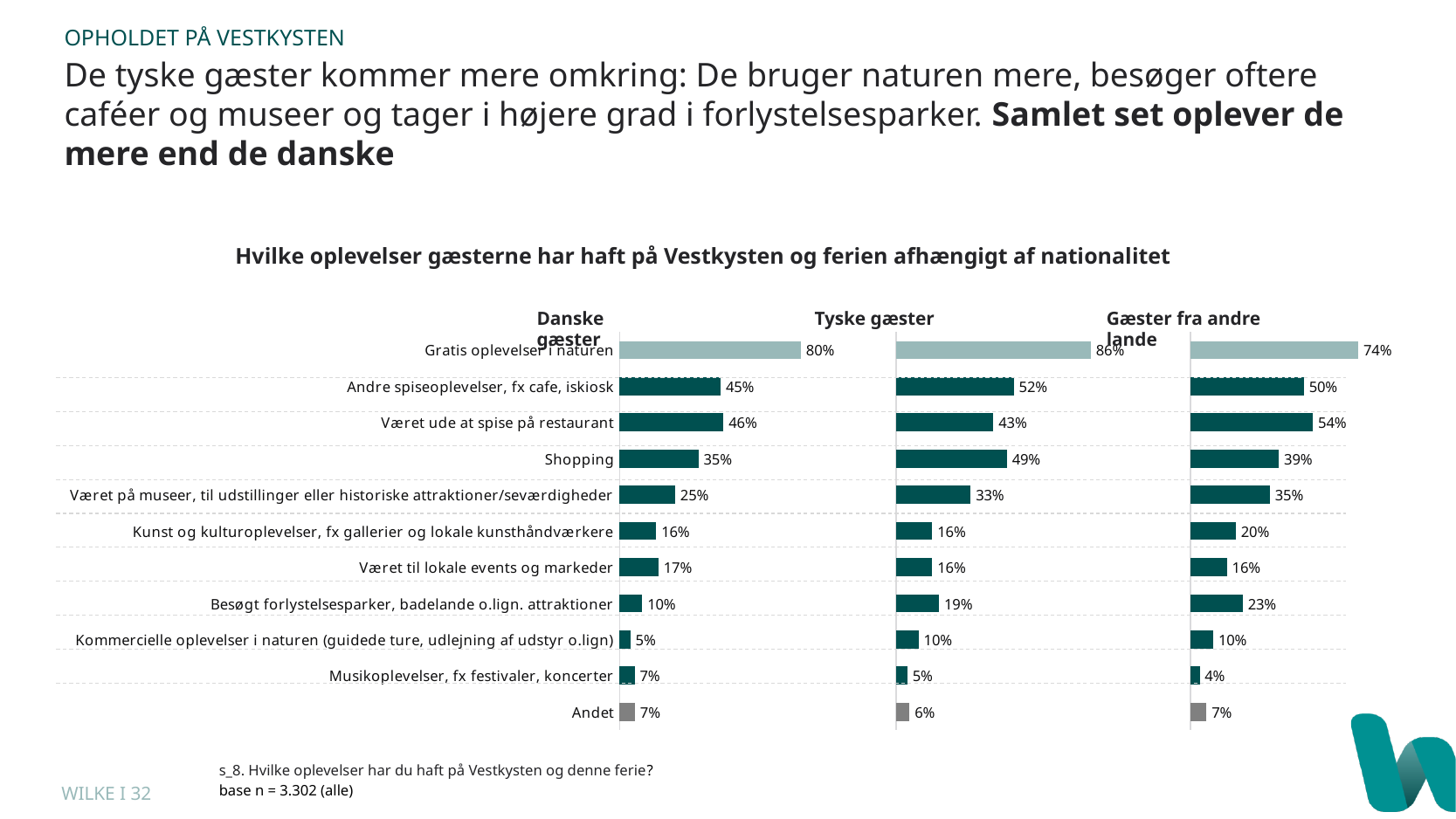
What is the difference between the Tyske gæster and Danske gæster values for Shopping? 14% What is the difference between the Gæster fra andre lande and Danske gæster values for Været på museer, til udstillinger eller historiske attraktioner/seværdigheder? 10% In the Danske gæster chart, what is the value for Shopping? 35% What is the title of the chart on the slide? Hvilke oplevelser gæsterne har haft på Vestkysten og ferien afhængigt af nationalitet In the Tyske gæster chart, which category has the highest value? Gratis oplevelser i naturen In the Danske gæster chart, which category has the lowest value? Kommercielle oplevelser i naturen (guidede ture, udlejning af udstyr o.lign) What kind of chart is used on this slide? Bar chart For Besøgt forlystelsesparker, badelande o.lign. attraktioner, which is larger: the Tyske gæster value or the Danske gæster value? Tyske gæster In the Tyske gæster chart, what is the value for Gratis oplevelser i naturen? 86% In the Gæster fra andre lande chart, which category has the lowest value? Musikoplevelser, fx festivaler, koncerter In the Gæster fra andre lande chart, what is the value for Været ude at spise på restaurant? 54% How many categories are shown in the Danske gæster chart? 11